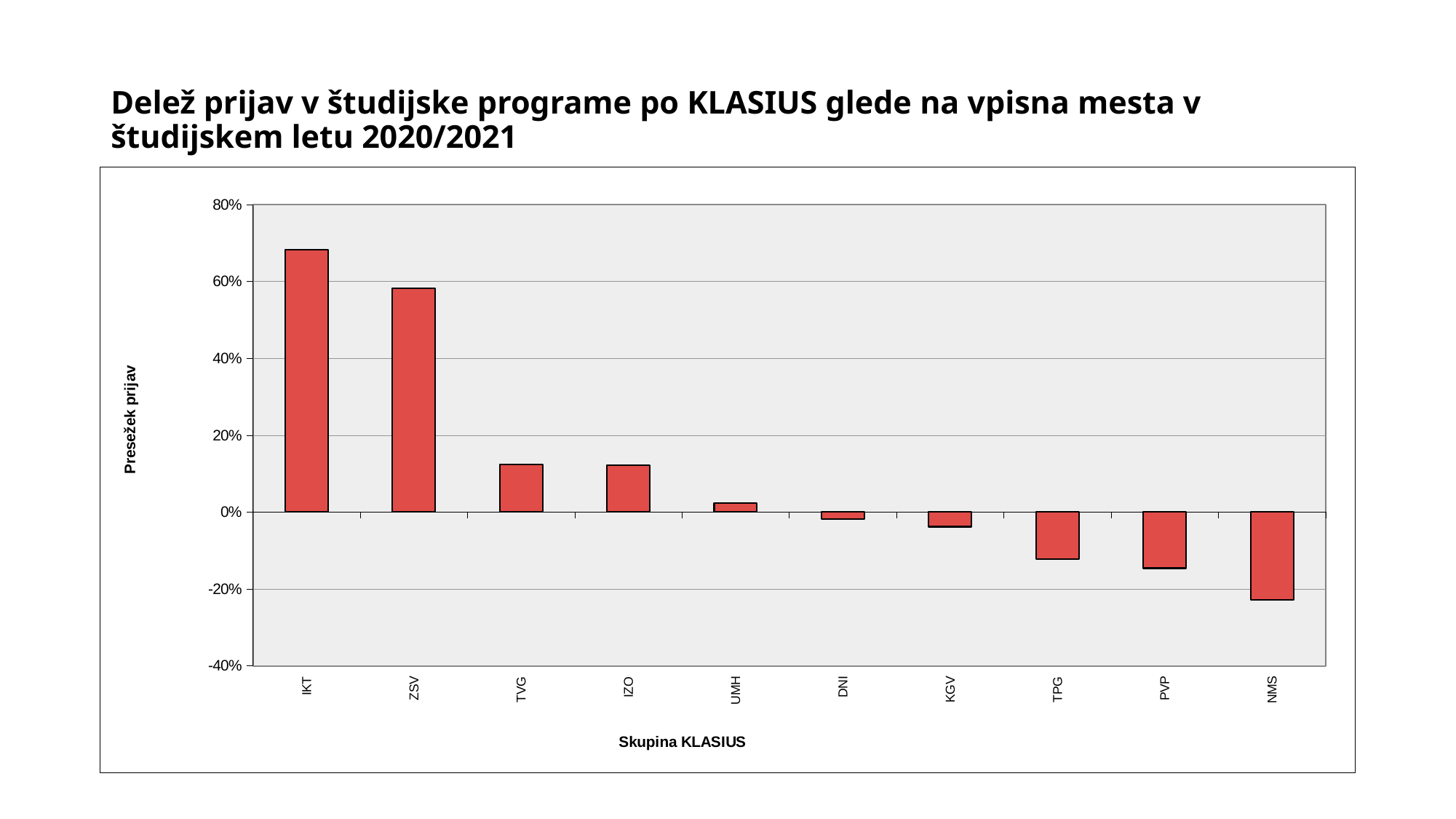
How many KLASIUS groups are plotted on the x axis? 10 Which has the larger value, IKT or ZSV? IKT Do the values generally rise or fall moving from left to right along the x axis? fall What kind of chart is shown on the slide? bar chart Is the value for ZSV greater or less than 60%? less Which KLASIUS group has the highest value? IKT Is the value for TVG greater or less than 20%? less Is the value for NMS greater or less than -20%? less Which KLASIUS group has the lowest value? NMS What is the title of the vertical axis? Presežek prijav